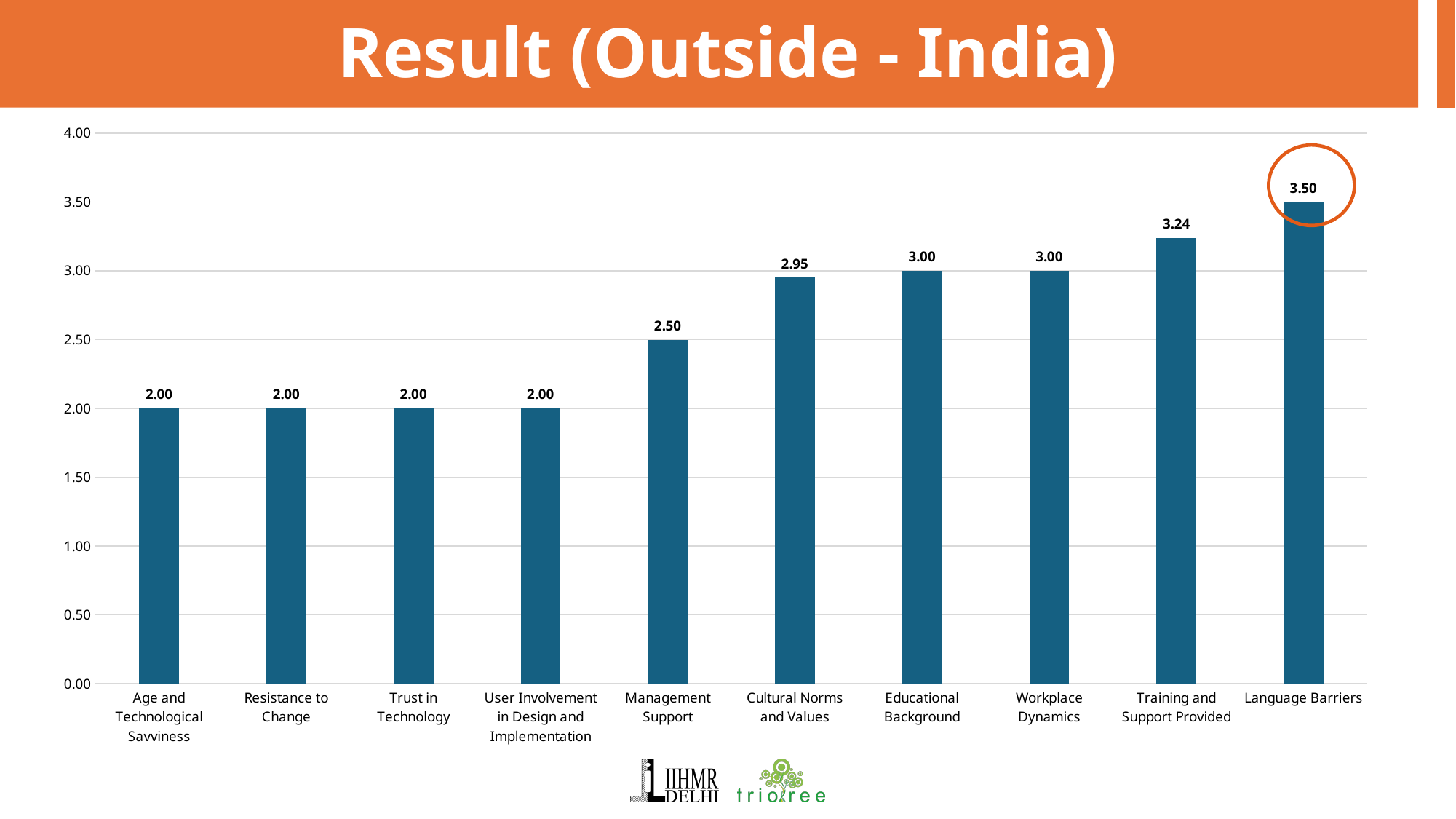
What is the difference between the values for Management Support and Trust in Technology? 0.50 What is the value for Cultural Norms and Values? 2.95 How many categories are shown on the x axis? 10 What kind of chart is shown on the slide? Bar chart Do the values generally rise or fall from left to right along the x axis? Rise What is the value for Training and Support Provided? 3.24 Which category has the highest value? Language Barriers Which is larger, the value for Cultural Norms and Values or the value for Educational Background? Educational Background What is the difference between the values for Language Barriers and Training and Support Provided? 0.26 Which bar's data label is circled in orange? Language Barriers What is the value for Management Support? 2.50 What is the value for Language Barriers? 3.50